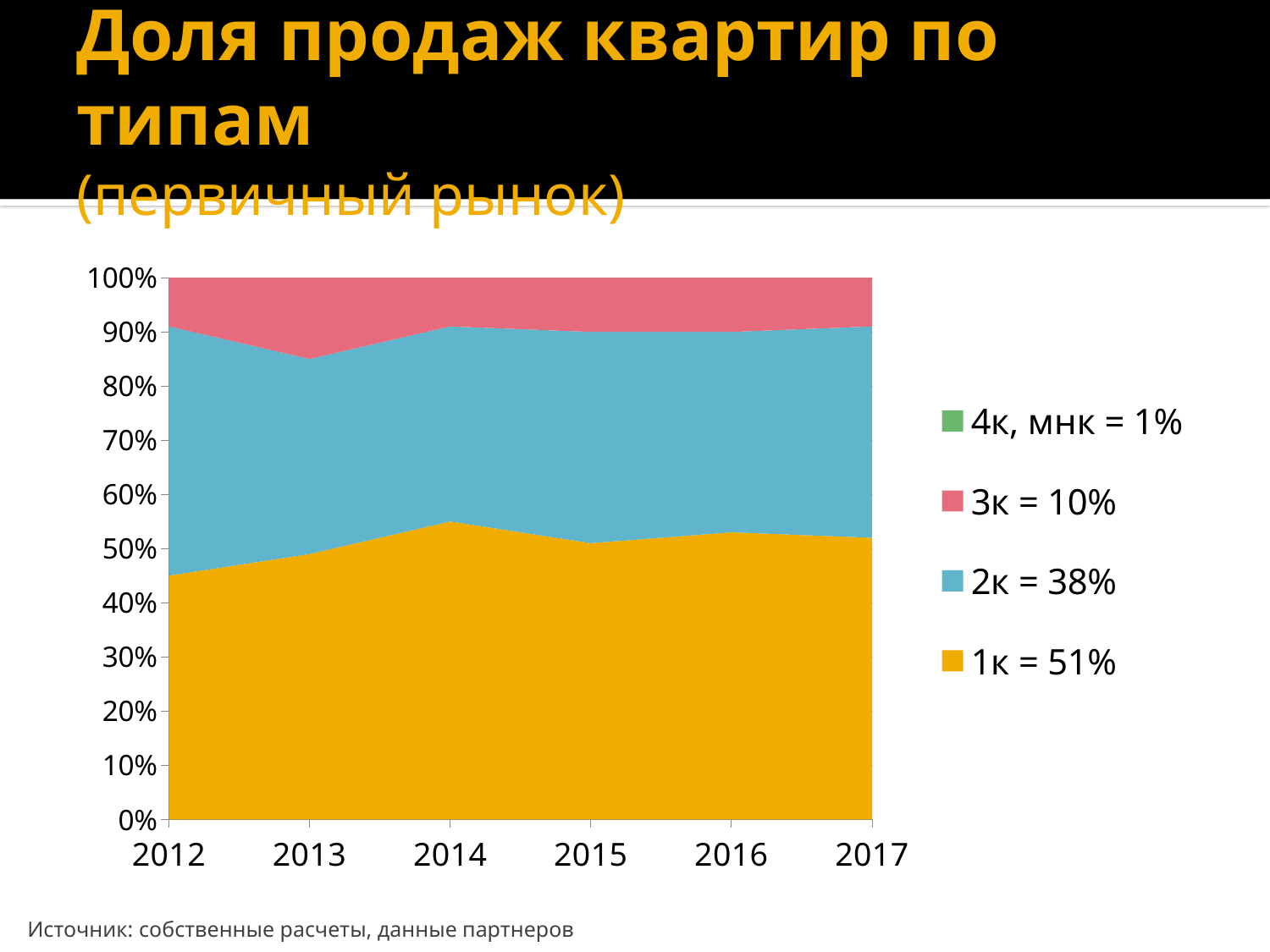
What share is given for 2к in the chart legend? 38% What share is given for 1к in the chart legend? 51% According to the legend, which apartment type has the largest share of sales? 1к Is the share of 1к in 2012 greater or less than 50%? less What share is given for 3к in the chart legend? 10% How many series does the chart legend list? 4 According to the legend, which apartment type has the smallest share of sales? 4к, мнк Is the share of 1к in 2014 greater or less than 50%? greater Does the share of 1к rise or fall from 2012 to 2014? rises What kind of chart is shown on the slide? Stacked area chart How many years are shown along the x axis of the chart? 6 What share is given for 4к, мнк in the chart legend? 1%